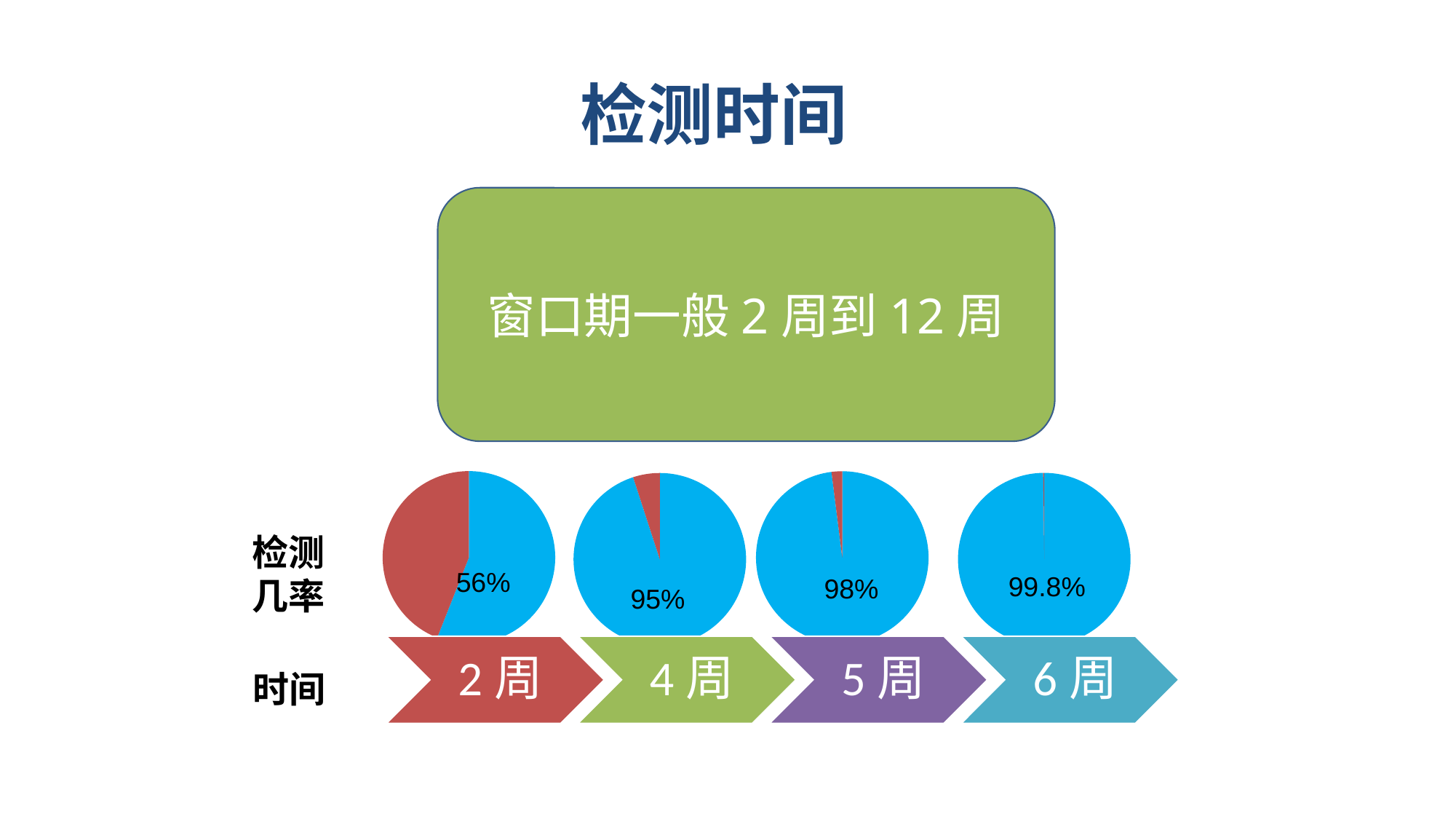
What is the detection probability (检测几率) shown for 2 周? 56% What kind of charts are used to show the detection probabilities? Pie charts How many pie charts are shown on the slide? 4 What is the detection probability (检测几率) shown for 5 周? 98% Which time point has the lowest detection probability? 2 周 What is the detection probability (检测几率) shown for 6 周? 99.8% In the pie chart for 2 周, what share of the pie does the blue slice represent? 56% Which is larger, the detection probability at 5 周 or at 4 周? 5 周 What is the detection probability (检测几率) shown for 4 周? 95% What is the difference in percentage points between the detection probability at 4 周 and at 2 周? 39 Does the detection probability rise or fall as the time increases from 2 周 to 6 周? Rise Which time point has the highest detection probability? 6 周